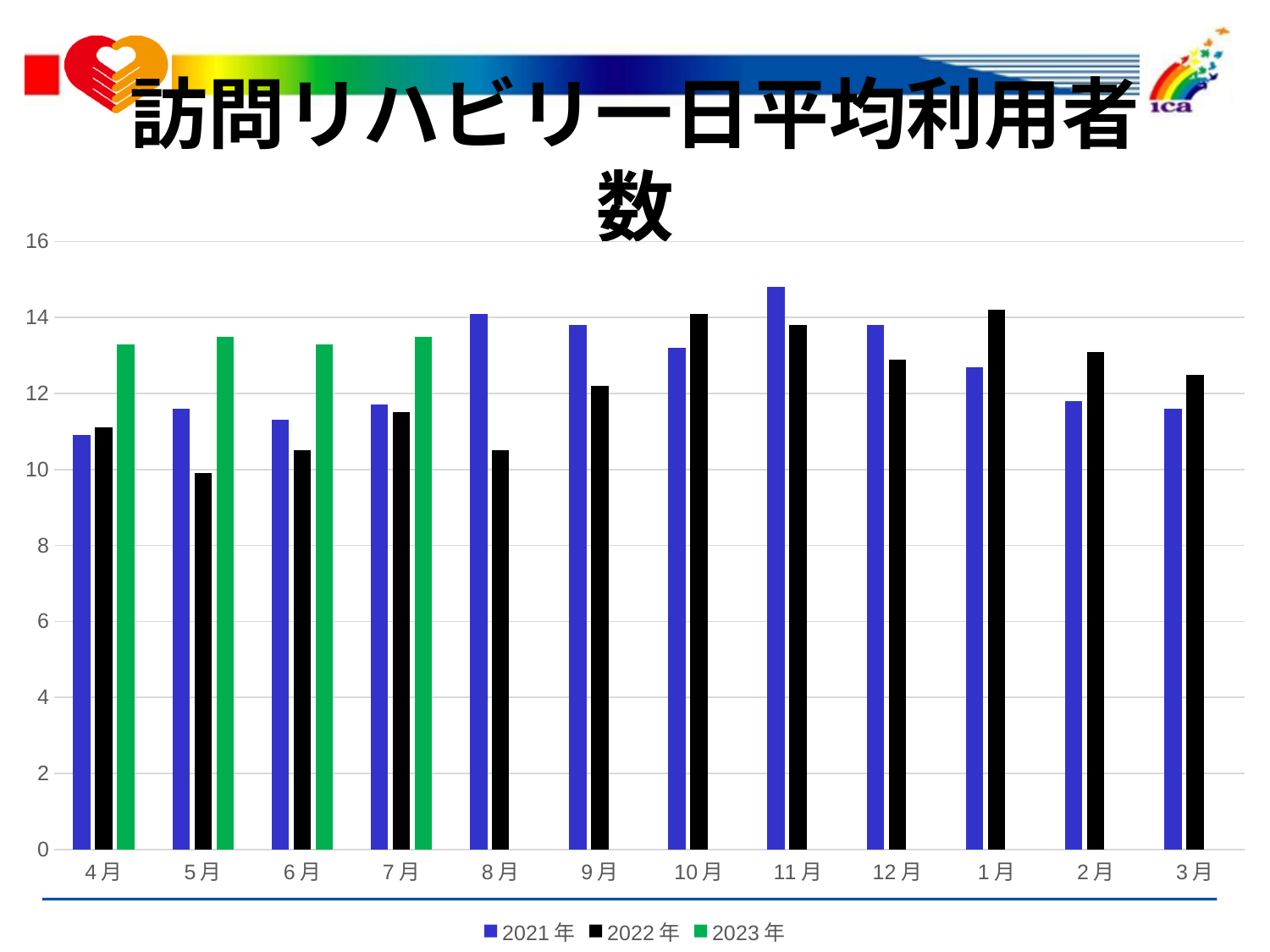
For how many months is a 2023年 bar plotted? 4 In 8月, which series has the larger value, 2021年 or 2022年? 2021年 What kind of chart is shown on the slide? bar chart What is the title of the chart? 訪問リハビリ一日平均利用者数 How many months are shown on the x axis? 12 In 4月, which series has the larger value, 2021年 or 2023年? 2023年 In which month is the 2022年 value lowest? 5月 In which month is the 2021年 value highest? 11月 Is the 2021年 value for 11月 greater or less than 14? greater Which colour represents the 2023年 series? green How many series does the legend list? 3